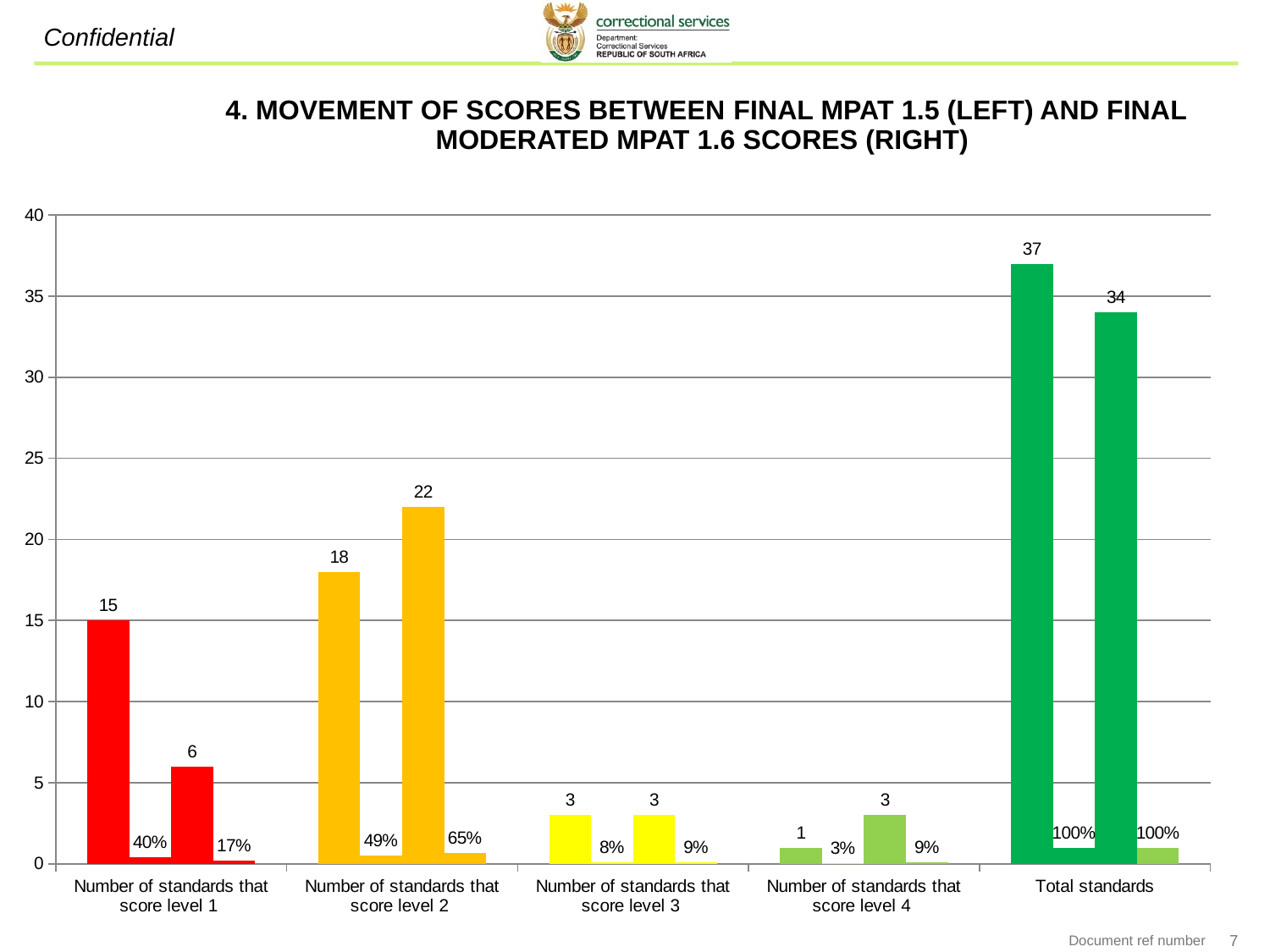
What is the difference between the number of standards scoring level 1 in MPAT 1.5 (left) and in MPAT 1.6 (right)? 9 What is the number of standards that score level 2 in the final moderated MPAT 1.6 (right bar)? 22 What is the number of standards that score level 1 in the final MPAT 1.5 (left bar)? 15 What is the total number of standards in the final MPAT 1.5 (left bar)? 37 How many categories are shown on the x axis of the chart? 5 Is the total number of standards in the final moderated MPAT 1.6 (right) greater or less than 35? less What percentage of standards scored level 1 in the final moderated MPAT 1.6 (right)? 17% Which score level has the highest number of standards in the final moderated MPAT 1.6 (right bars)? Number of standards that score level 2 What kind of chart is shown on the slide? Bar chart Which is larger: the number of standards scoring level 2 in MPAT 1.5 (left) or in MPAT 1.6 (right)? MPAT 1.6 (right) What colour are the bars for the Total standards category? Green Which score level has the lowest number of standards in the final MPAT 1.5 (left bars)? Number of standards that score level 4